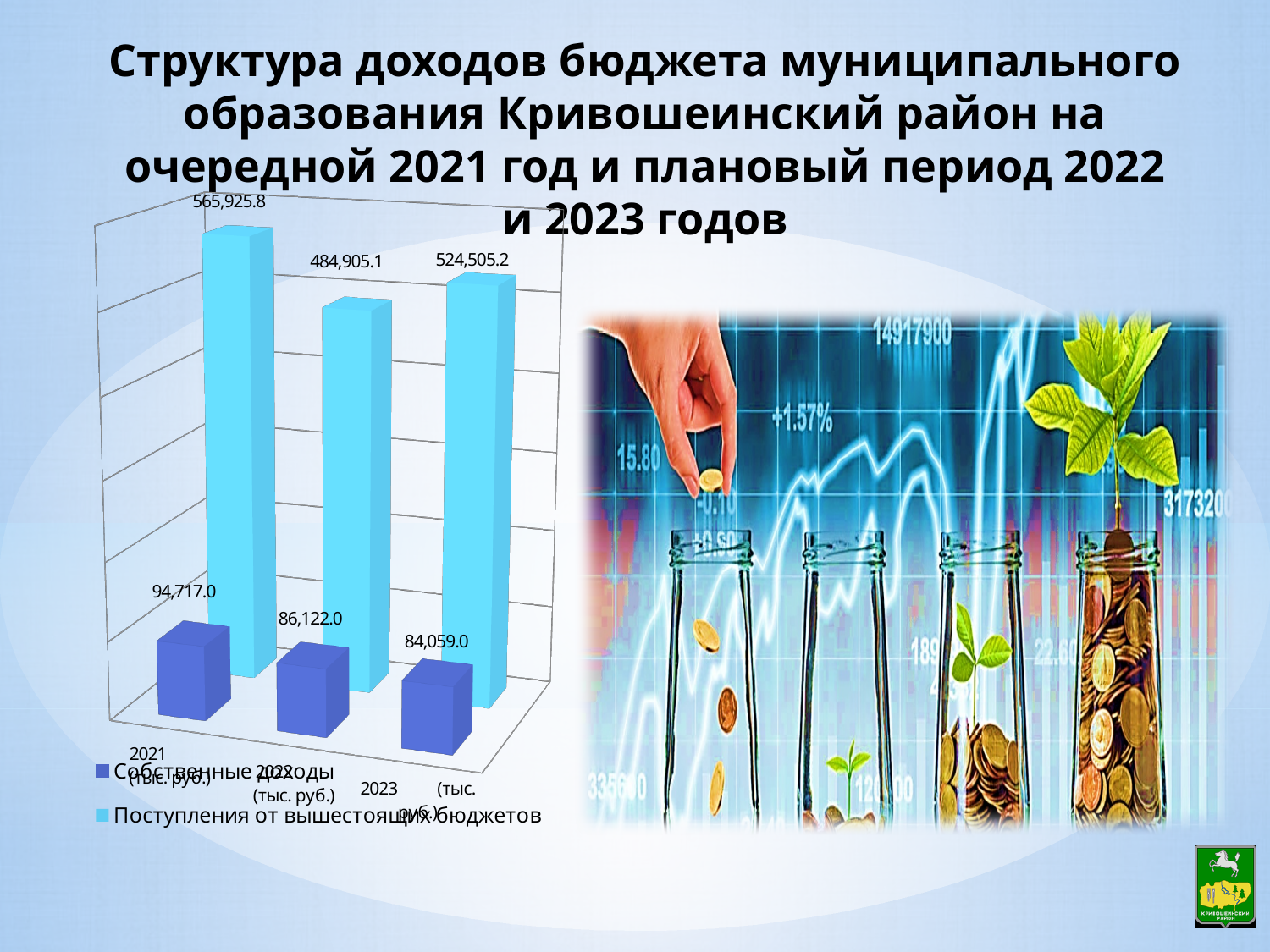
What kind of chart is shown on the slide? Bar chart How many years are shown on the chart? 3 What is the value of Собственные доходы for 2022? 86,122.0 Which is larger: Поступления от вышестоящих бюджетов in 2022 or in 2023? 2023 In which year is Поступления от вышестоящих бюджетов the highest? 2021 What is the value of Поступления от вышестоящих бюджетов for 2023? 524,505.2 What is the value of Поступления от вышестоящих бюджетов for 2021? 565,925.8 In which year is Собственные доходы the lowest? 2023 What is the difference between Собственные доходы in 2021 and in 2022? 8,595.0 What is the difference between Поступления от вышестоящих бюджетов in 2021 and in 2022? 81,020.7 How many series does the legend list? 2 What is the value of Собственные доходы for 2023? 84,059.0